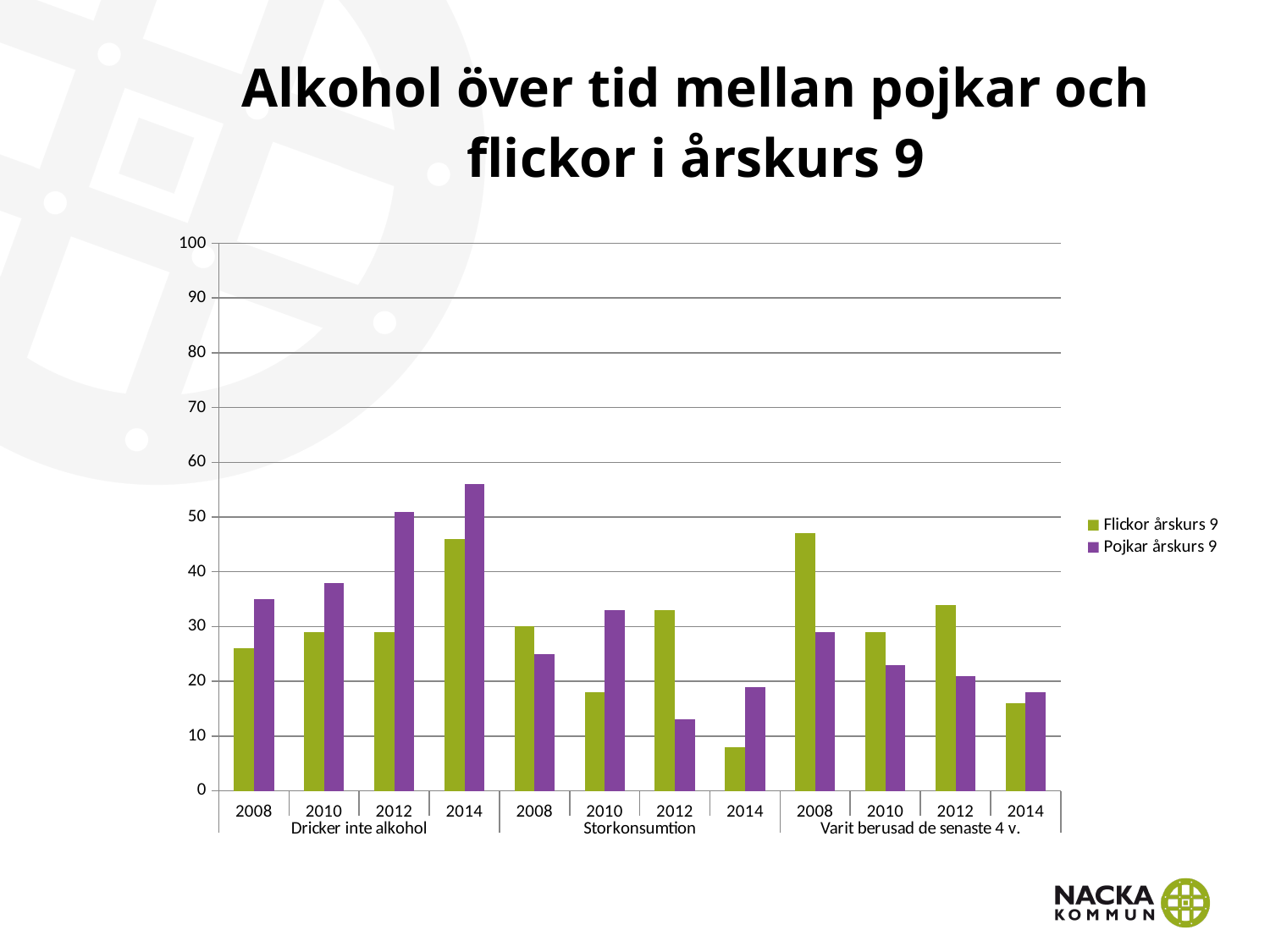
Under 'Storkonsumtion' in 2012, which series has the larger value, Flickor årskurs 9 or Pojkar årskurs 9? Flickor årskurs 9 What kind of chart is shown on the slide? bar chart How many series does the legend list? 2 Which colour represents Pojkar årskurs 9 in the legend? purple Is the value for Flickor årskurs 9 in 2014 under 'Storkonsumtion' greater or less than 10? less Which bar is the tallest in the whole chart? Pojkar årskurs 9, 2014, Dricker inte alkohol Do the Pojkar årskurs 9 values under 'Dricker inte alkohol' rise or fall from 2008 to 2014? rise Is the value for Flickor årskurs 9 in 2008 under 'Varit berusad de senaste 4 v.' greater or less than 40? greater Is the value for Pojkar årskurs 9 in 2014 under 'Dricker inte alkohol' greater or less than 50? greater Under 'Dricker inte alkohol' in 2012, which series has the larger value, Flickor årskurs 9 or Pojkar årskurs 9? Pojkar årskurs 9 Which bar is the shortest in the whole chart? Flickor årskurs 9, 2014, Storkonsumtion How many year labels appear under the 'Storkonsumtion' group on the x axis? 4